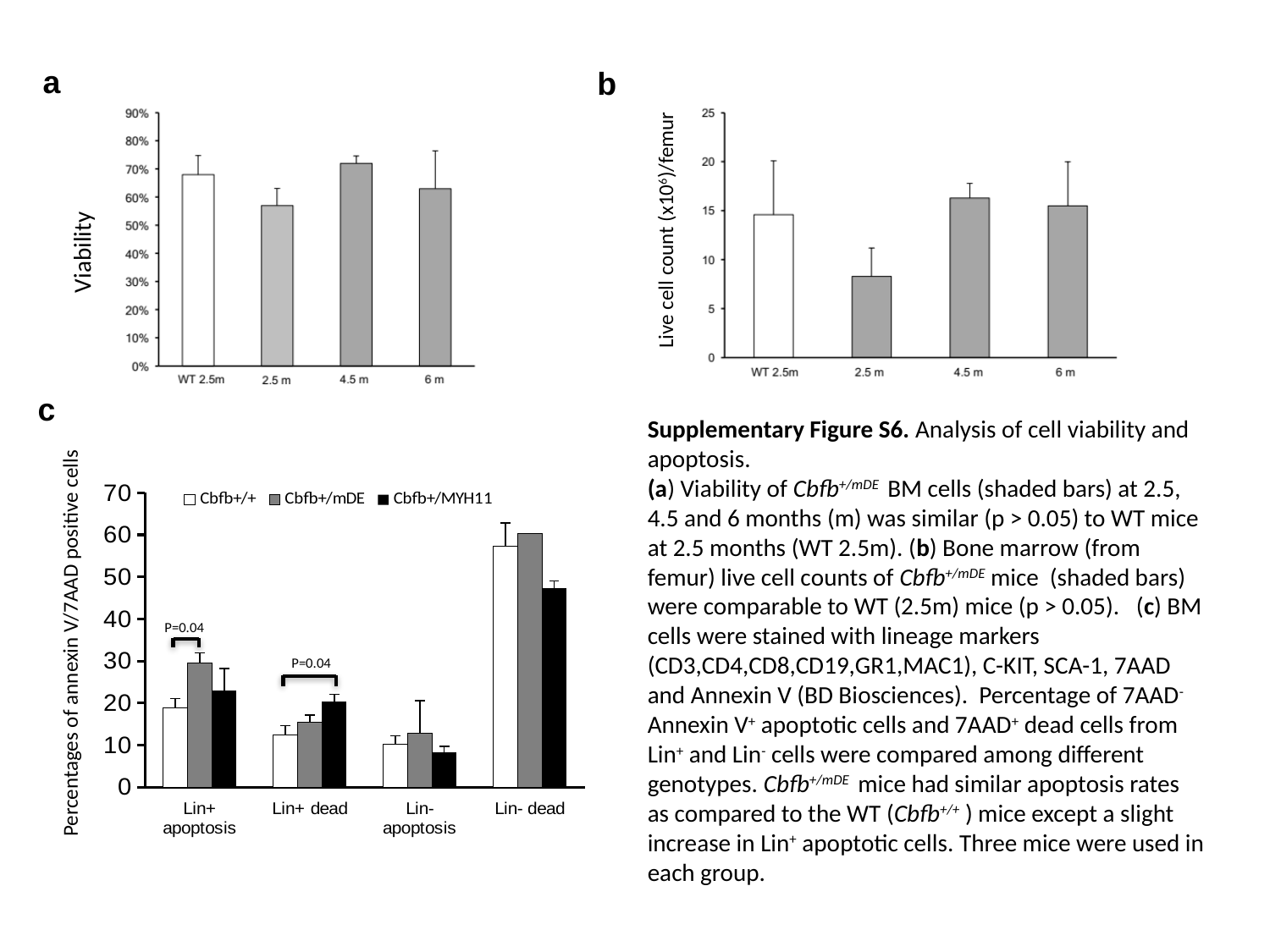
In chart a (Viability), how many categories are shown on the x axis? 4 What kind of chart is chart b (Live cell count)? bar chart In chart c (Percentages of annexin V/7AAD positive cells), which category has the highest values? Lin- dead In chart c (Percentages of annexin V/7AAD positive cells), for Lin+ apoptosis, which is larger, the Cbfb+/+ value or the Cbfb+/mDE value? Cbfb+/mDE In chart c (Percentages of annexin V/7AAD positive cells), is the Cbfb+/+ value for Lin+ dead greater or less than 20? less In chart a (Viability), which category has the lowest viability? 2.5 m In chart b (Live cell count), is the value for 2.5 m greater or less than 10? less In chart b (Live cell count), which category has the lowest live cell count? 2.5 m In chart a (Viability), is the value for 2.5 m greater or less than 60%? less In chart b (Live cell count), which is larger, the value for 4.5 m or the value for 2.5 m? 4.5 m In chart c (Percentages of annexin V/7AAD positive cells), how many series does the legend list? 3